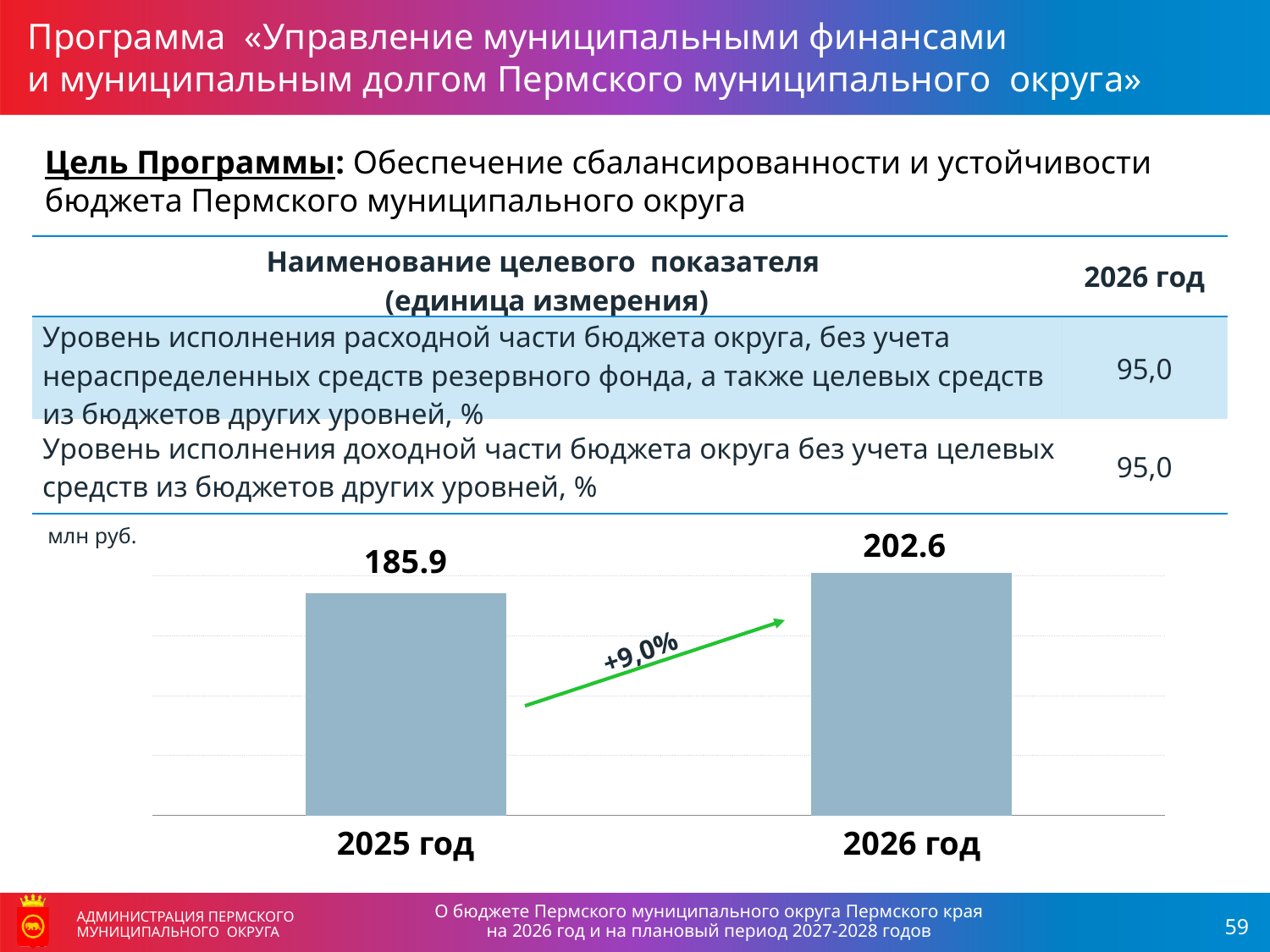
What is the difference between the values for 2026 год and 2025 год on the chart? 16.7 What is the value for 2025 год on the chart? 185.9 How many bars are shown on the chart? 2 What is the value for 2026 год on the chart? 202.6 What kind of chart is shown on the slide? bar chart Is the value for 2026 год larger or smaller than the value for 2025 год? larger Which year has the lower value on the chart? 2025 год Which year has the higher value on the chart? 2026 год What percentage change is shown by the arrow between the two bars? +9,0% What unit of measurement is indicated for the chart values? млн руб. Do the values rise or fall from 2025 год to 2026 год? rise